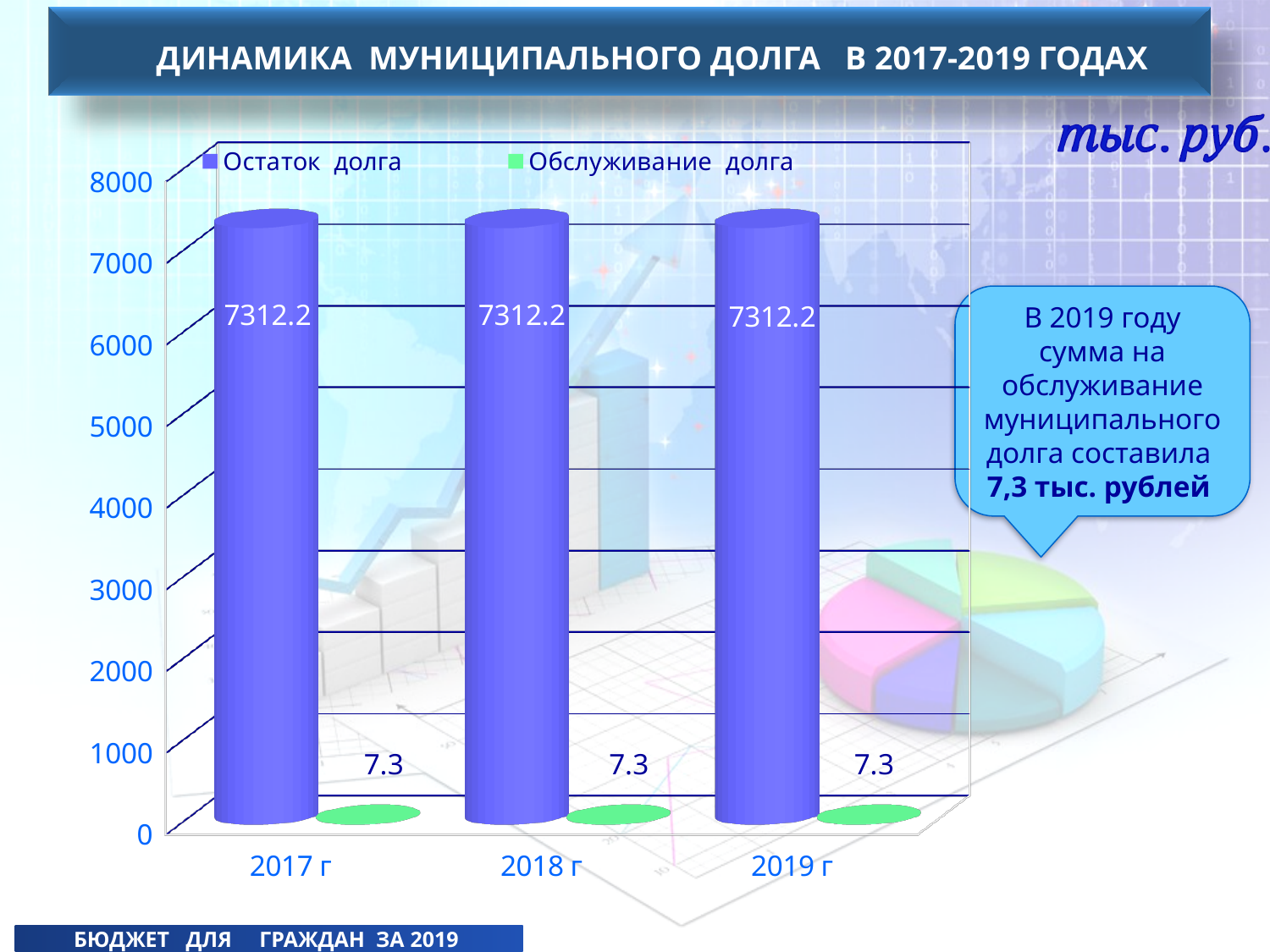
Does Остаток долга rise, fall or stay the same from 2017 г to 2019 г? stays the same What is the value of Остаток долга for 2017 г? 7312.2 What kind of chart is shown on the slide? bar chart How many series does the legend list? 2 What is the value of Остаток долга for 2019 г? 7312.2 How many years are shown on the x axis? 3 What is the value of Обслуживание долга for 2019 г? 7.3 Is the value of Остаток долга for 2017 г greater or less than 7000? greater What is the difference between Остаток долга and Обслуживание долга in 2019 г? 7304.9 Which is larger in 2018 г: Остаток долга or Обслуживание долга? Остаток долга What is the value of Обслуживание долга for 2018 г? 7.3 What unit is indicated for the chart values? тыс. руб.